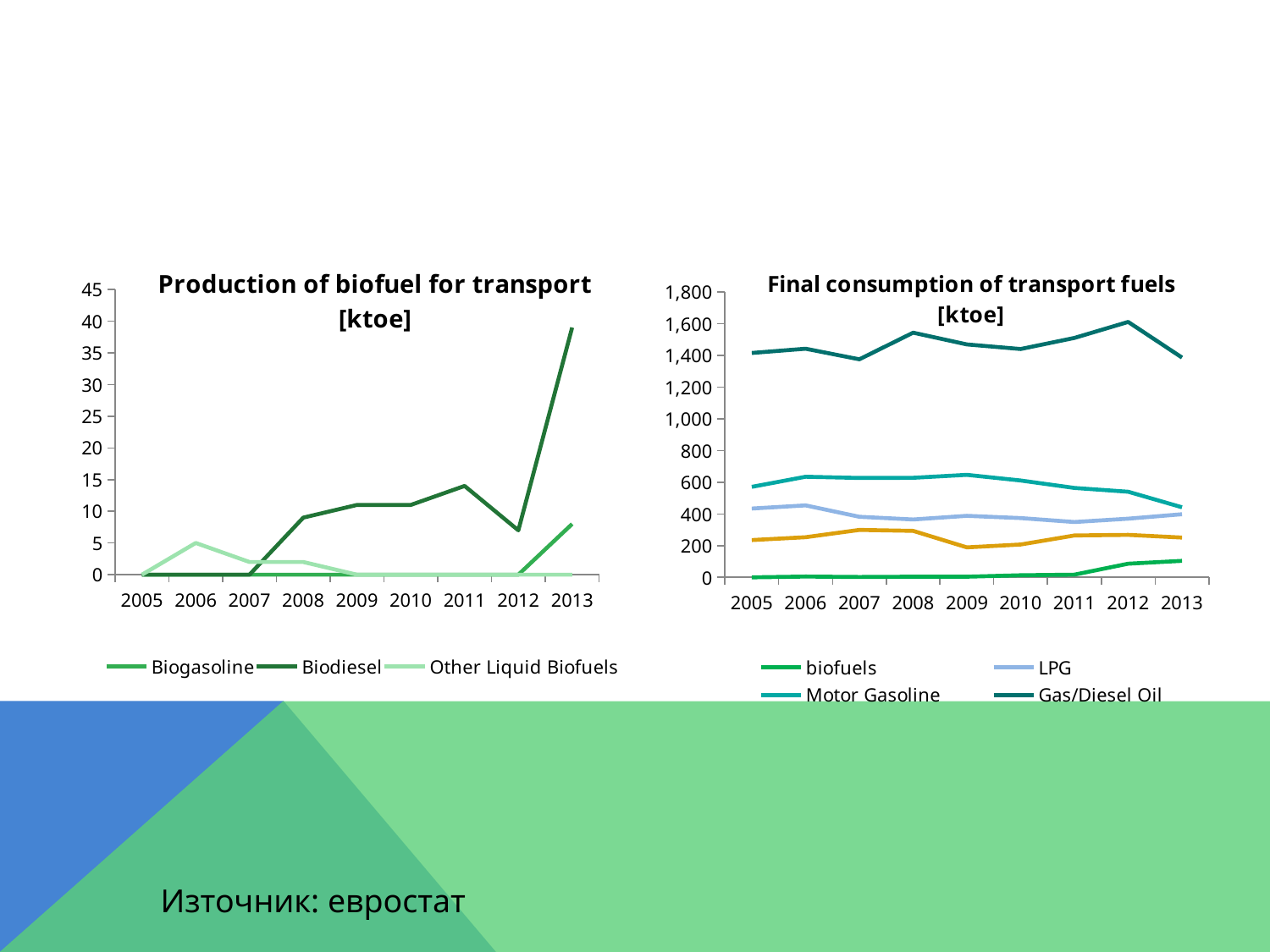
In the 'Final consumption of transport fuels [ktoe]' chart, is the Gas/Diesel Oil value for 2012 greater or less than 1,400? greater In the 'Production of biofuel for transport [ktoe]' chart, in which year does Other Liquid Biofuels reach its highest value? 2006 How many years are shown on the x axis of the 'Production of biofuel for transport [ktoe]' chart? 9 In the 'Production of biofuel for transport [ktoe]' chart, is the Biodiesel value for 2013 greater or less than 35? greater In the 'Production of biofuel for transport [ktoe]' chart, in which year is Biodiesel production highest? 2013 In the 'Final consumption of transport fuels [ktoe]' chart, which is larger in 2005: Motor Gasoline or LPG? Motor Gasoline What kind of chart is the 'Production of biofuel for transport [ktoe]' chart? line chart In the 'Production of biofuel for transport [ktoe]' chart, is the Biodiesel value for 2012 greater or less than 10? less In the 'Final consumption of transport fuels [ktoe]' chart, which series has the lowest values throughout the period? biofuels In the 'Final consumption of transport fuels [ktoe]' chart, which series has the highest values throughout the period? Gas/Diesel Oil How many series does the legend of the 'Production of biofuel for transport [ktoe]' chart list? 3 How many series does the legend of the 'Final consumption of transport fuels [ktoe]' chart list? 4